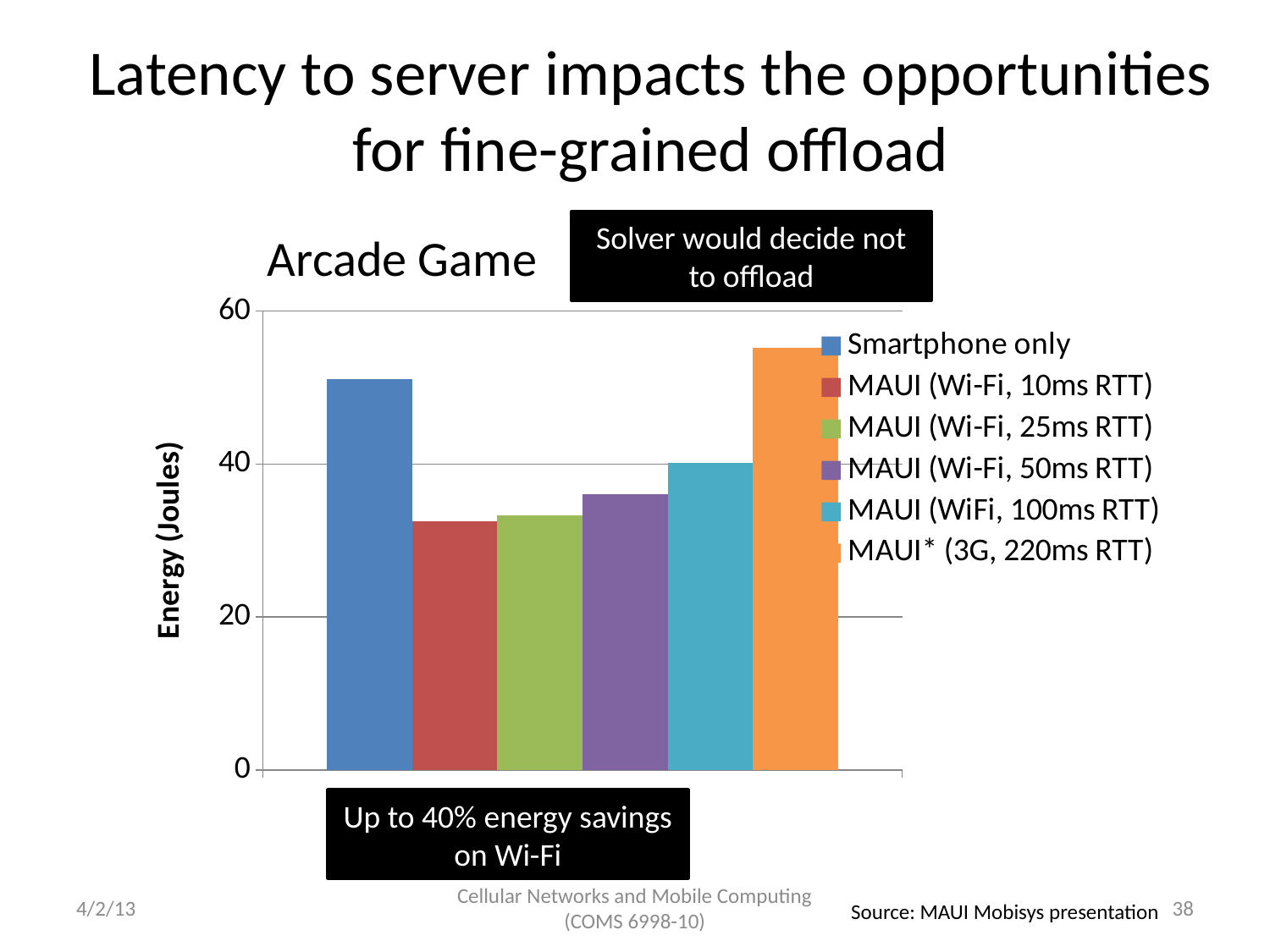
Is the value for MAUI (Wi-Fi, 50ms RTT) greater or less than 40? less What is the label on the y axis of the chart? Energy (Joules) Do the energy values for the MAUI series rise or fall as the RTT increases from 10ms to 220ms? rise What kind of chart is shown on the slide? bar chart Is the value for MAUI* (3G, 220ms RTT) greater or less than 40? greater Is the value for MAUI (Wi-Fi, 10ms RTT) greater or less than 40? less Which is larger, the value for Smartphone only or the value for MAUI* (3G, 220ms RTT)? MAUI* (3G, 220ms RTT) Which series has the highest energy value? MAUI* (3G, 220ms RTT) How many series does the legend list? 6 Which is larger, the value for MAUI (Wi-Fi, 50ms RTT) or the value for MAUI (WiFi, 100ms RTT)? MAUI (WiFi, 100ms RTT) Which is larger, the value for Smartphone only or the value for MAUI (Wi-Fi, 10ms RTT)? Smartphone only